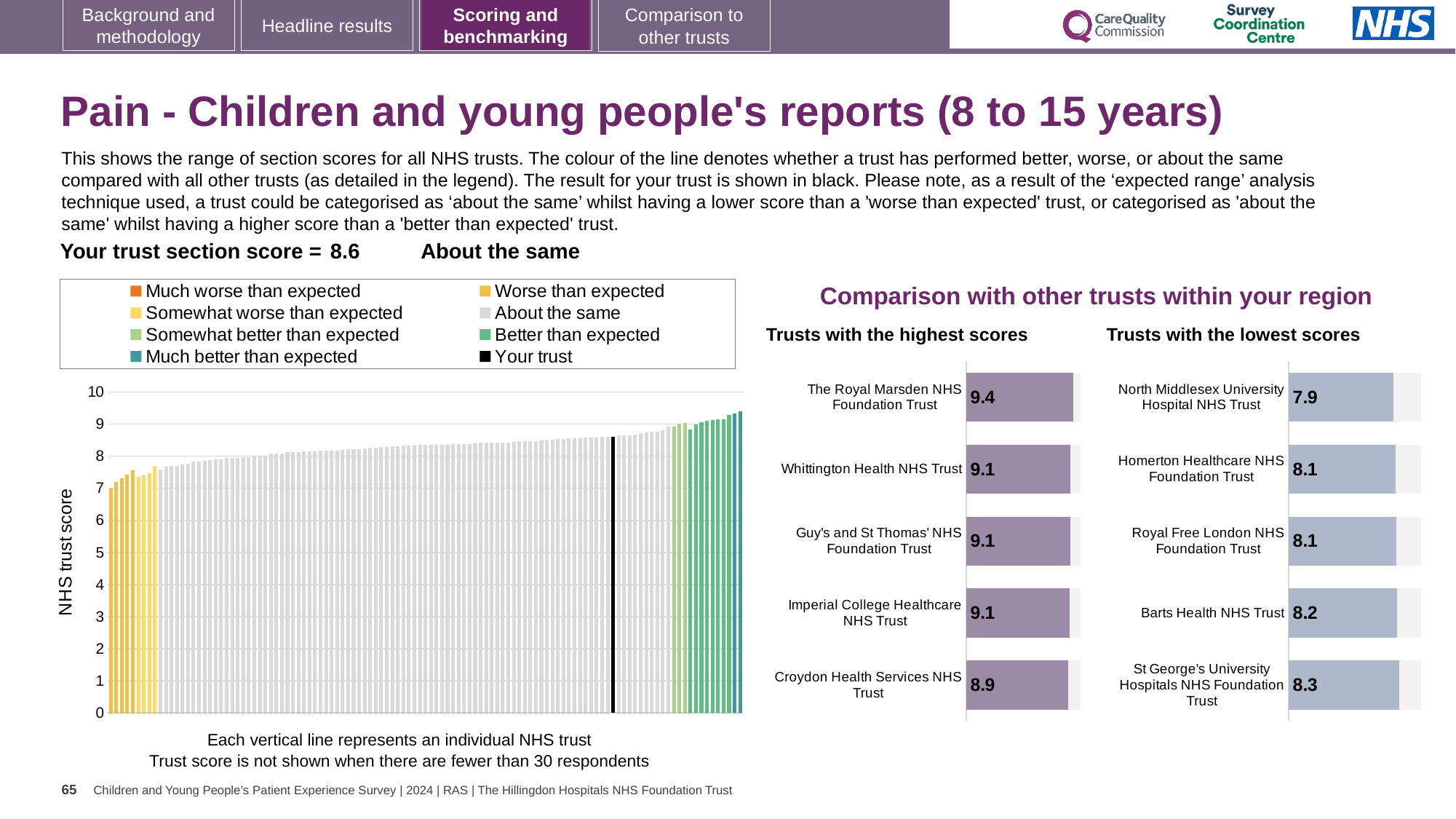
In the 'Trusts with the highest scores' chart, what is the score for Croydon Health Services NHS Trust? 8.9 In the 'Trusts with the highest scores' chart, which trust has the highest score? The Royal Marsden NHS Foundation Trust In the 'Trusts with the lowest scores' chart, what is the difference between the scores of St George's University Hospitals NHS Foundation Trust and North Middlesex University Hospital NHS Trust? 0.4 In the 'Trusts with the highest scores' chart, what is the score for The Royal Marsden NHS Foundation Trust? 9.4 In the 'Trusts with the lowest scores' chart, what is the score for North Middlesex University Hospital NHS Trust? 7.9 How many entries does the legend above the 'NHS trust score' chart list? 8 In the 'Trusts with the highest scores' chart, what is the difference between the scores of The Royal Marsden NHS Foundation Trust and Croydon Health Services NHS Trust? 0.5 In the 'Trusts with the lowest scores' chart, which trust has the lowest score? North Middlesex University Hospital NHS Trust In the 'Trusts with the lowest scores' chart, which has the higher score: Barts Health NHS Trust or Homerton Healthcare NHS Foundation Trust? Barts Health NHS Trust How many trusts are shown in the 'Trusts with the highest scores' chart? 5 What kind of chart is the 'NHS trust score' chart on the left of the slide? bar chart In the 'Trusts with the lowest scores' chart, what is the score for Barts Health NHS Trust? 8.2